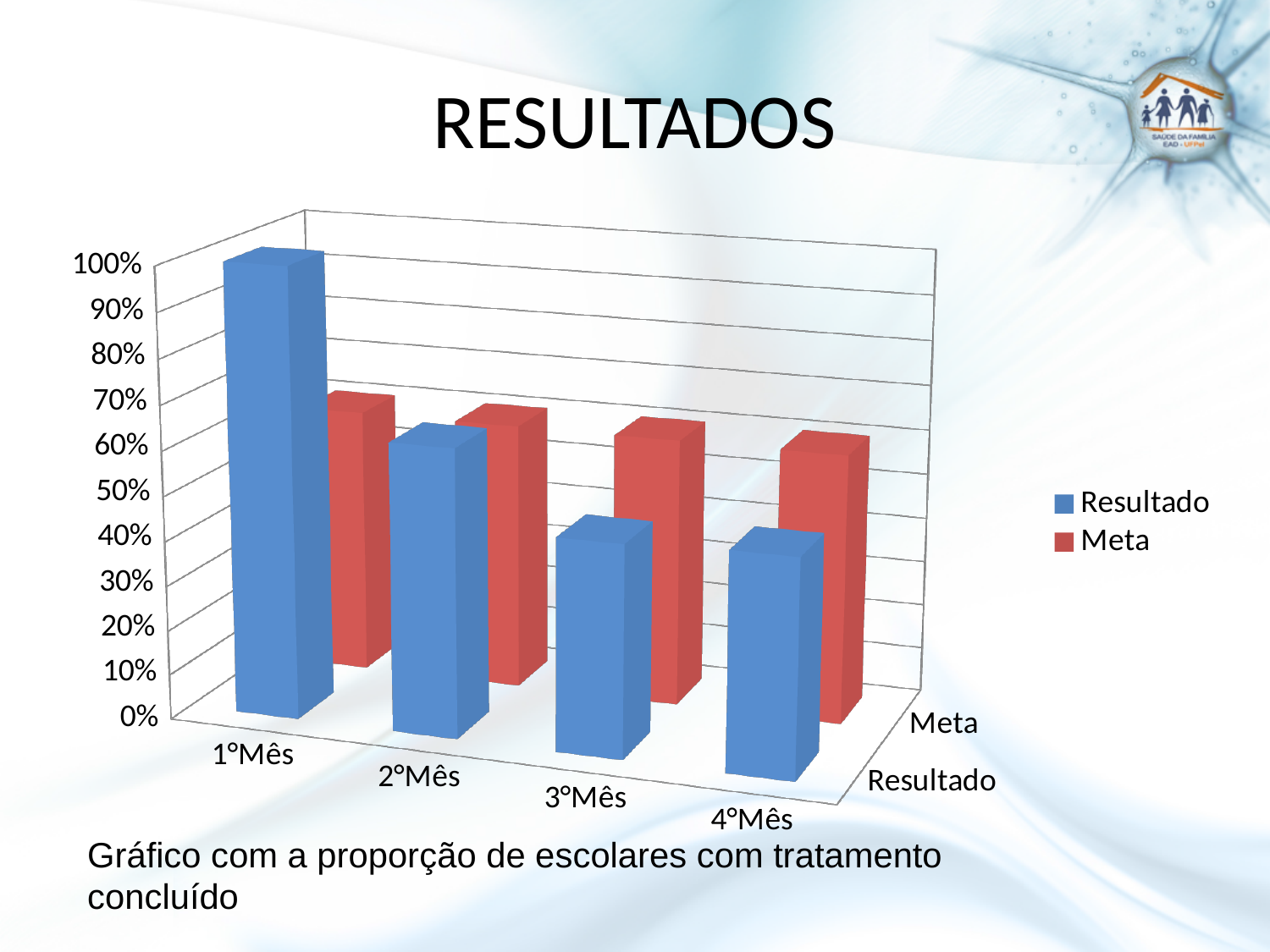
How many categories (months) are shown on the x axis of the chart? 4 In which month is the Resultado value highest? 1°Mês What colour are the Resultado bars in the chart? blue Is the Resultado value for 4°Mês greater or less than 50%? less How many series does the chart legend list? 2 Which series are listed in the chart legend? Resultado and Meta Is the Resultado value for 1°Mês greater or less than 80%? greater Do the Resultado values rise or fall from 1°Mês to 4°Mês? fall Which is larger, the Resultado value for 2°Mês or for 3°Mês? 2°Mês What kind of chart is shown on the slide? bar chart Which is larger, the Resultado value for 1°Mês or for 2°Mês? 1°Mês Is the Resultado value for 3°Mês greater or less than 50%? less